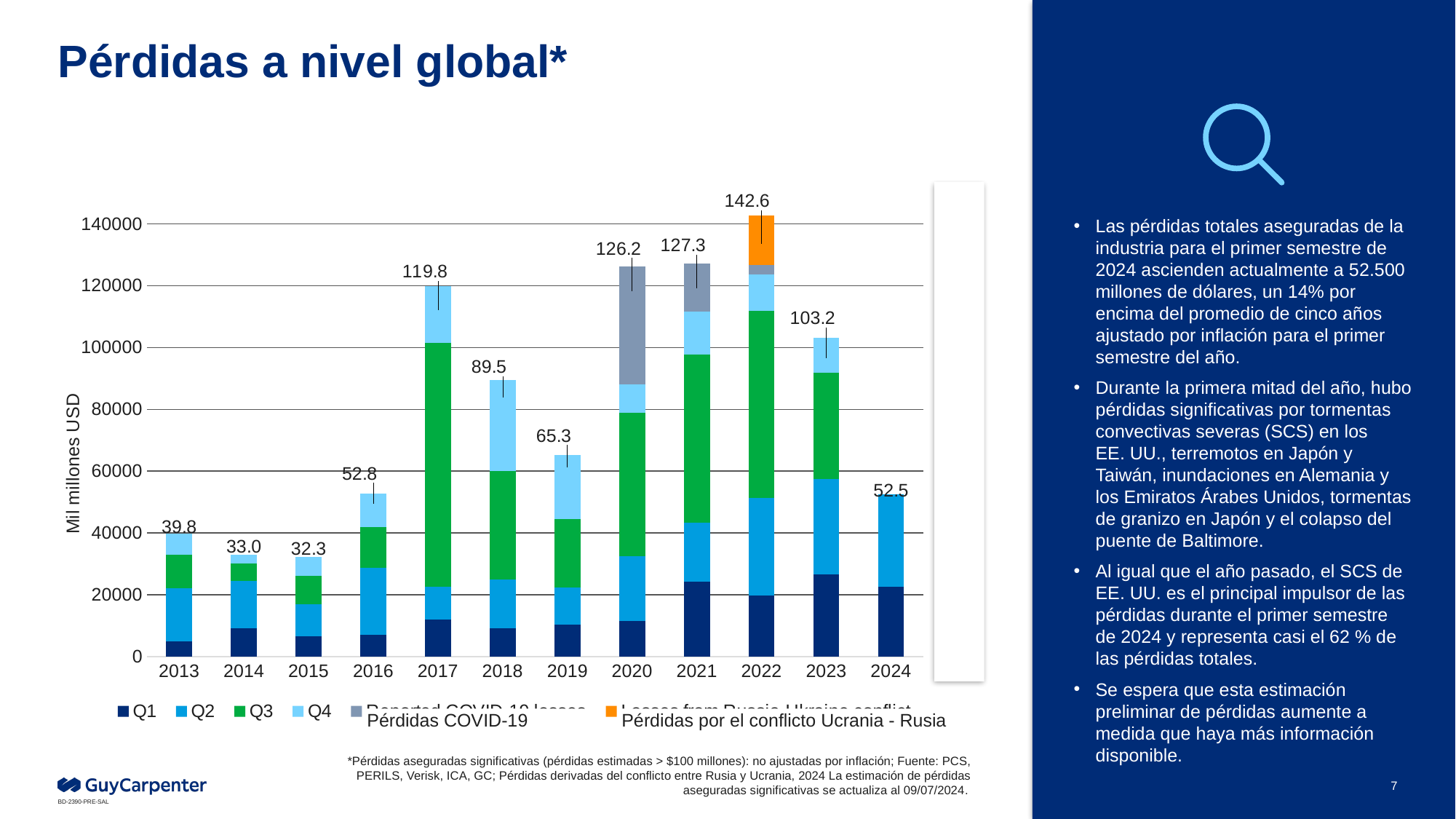
What is the difference between the total for 2022 and the total for 2021? 15.3 Is the Q1 value for 2021 greater or less than 20000? greater Which year has the lowest total losses? 2015 What is the total labeled value for 2017? 119.8 What is the total labeled value for 2022? 142.6 Which year has the highest total losses? 2022 How many series does the legend list? 6 How many years are shown on the x axis? 12 Do the total losses rise or fall from 2022 to 2024? Fall What is the difference between the total for 2023 and the total for 2024? 50.7 Which year has a larger total, 2020 or 2021? 2021 What kind of chart is shown on the slide? Stacked bar chart